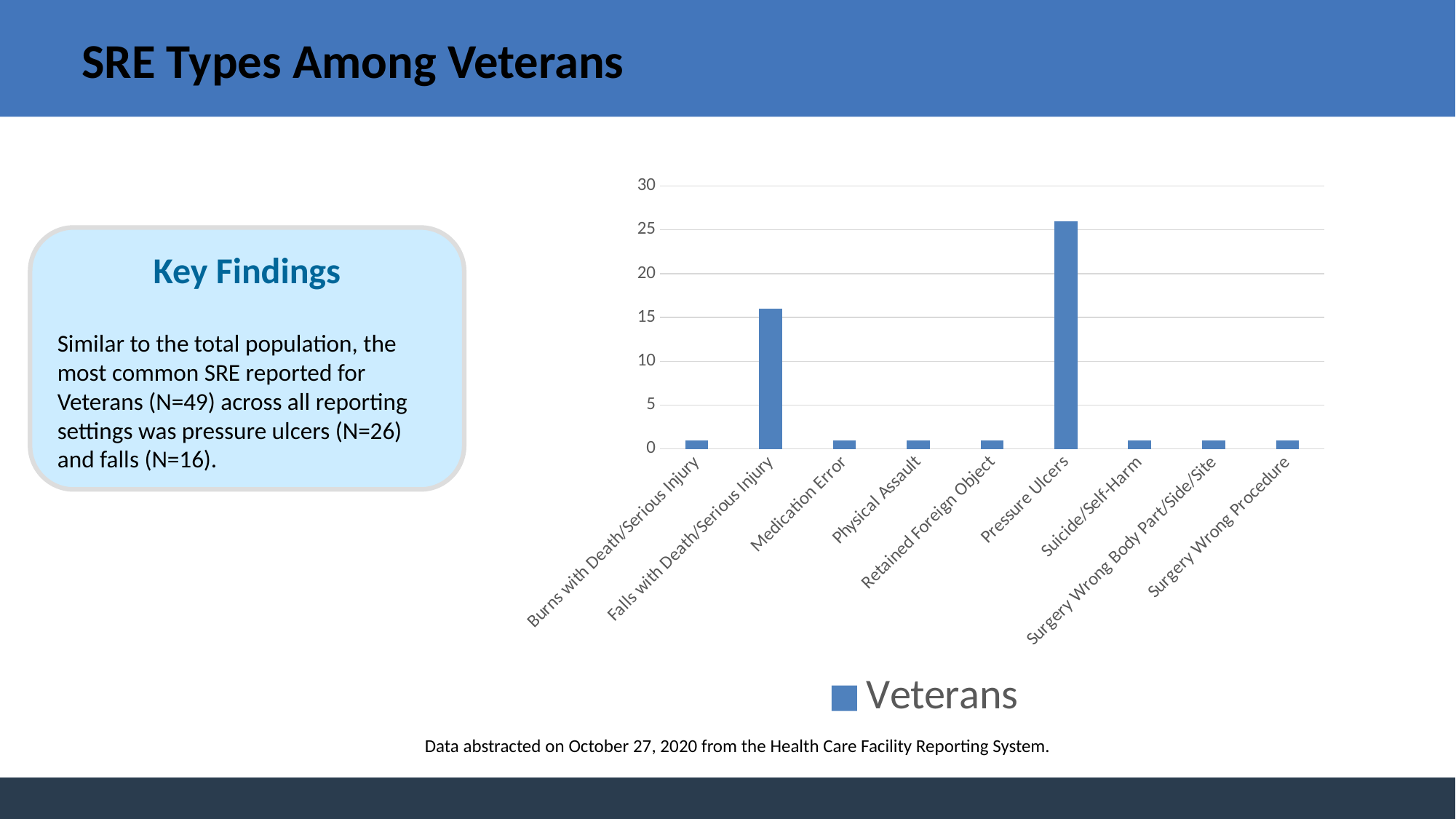
Is the value for Falls with Death/Serious Injury greater or less than 10? greater How many series does the chart legend list? 1 Is the value for Medication Error greater or less than 5? less Is the value for Falls with Death/Serious Injury greater or less than 20? less What series name is shown in the chart legend? Veterans Which is larger in the chart, the value for Falls with Death/Serious Injury or the value for Medication Error? Falls with Death/Serious Injury Which SRE type has the highest value in the chart? Pressure Ulcers How many SRE type categories are shown on the x axis of the chart? 9 Which is larger in the chart, the value for Pressure Ulcers or the value for Falls with Death/Serious Injury? Pressure Ulcers What kind of chart is shown on the slide? bar chart What is the title of the slide containing the chart? SRE Types Among Veterans